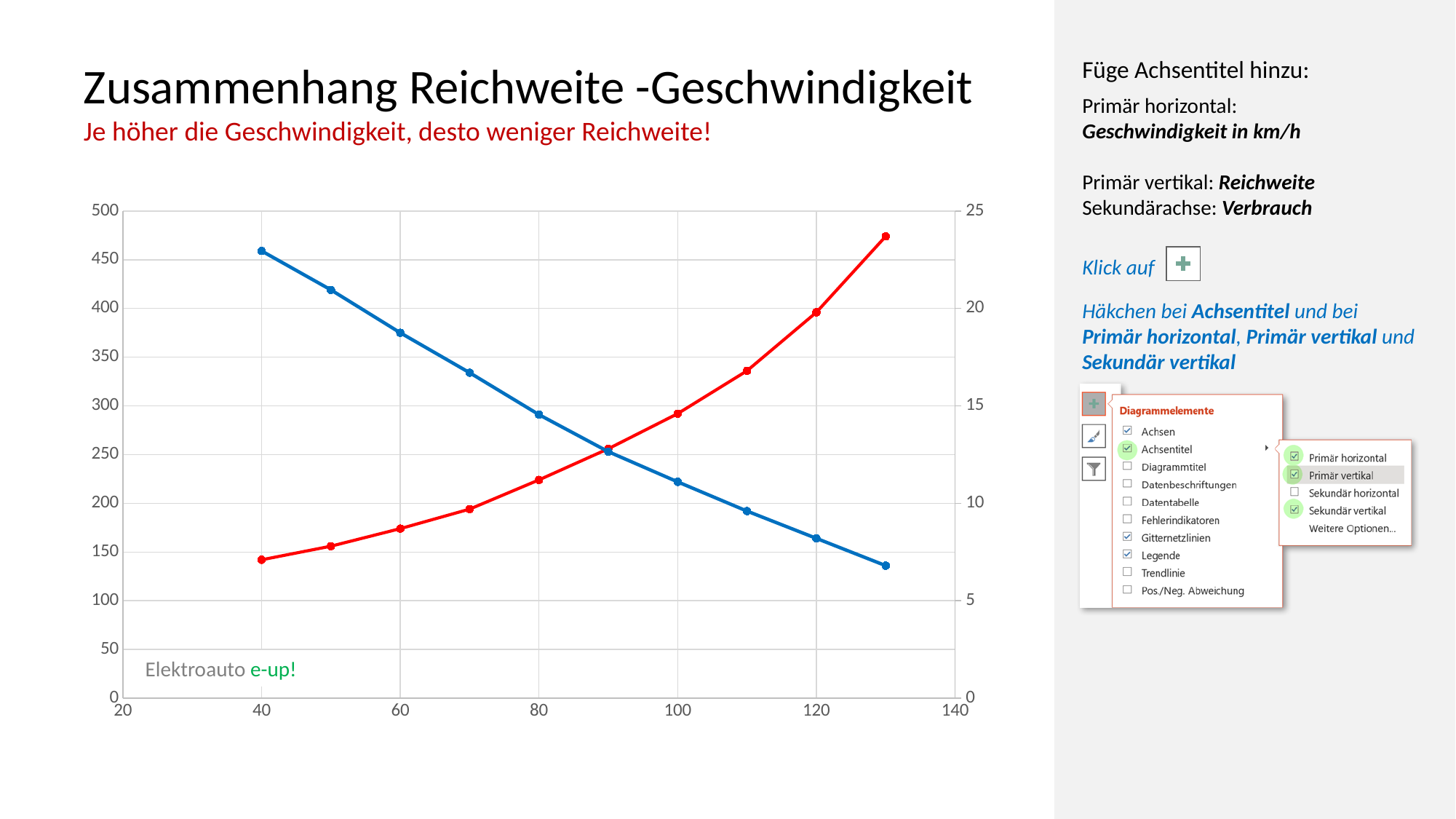
How many data points does the blue line have? 10 What kind of chart is shown on the slide? line chart At which x-axis value does the blue line reach its highest point? 40 Is the value of the blue line at x = 40 greater or less than 450 on the left axis? greater What is the highest tick value shown on the right-hand (secondary) vertical axis? 25 At which x-axis value does the red line reach its highest point? 130 Is the value of the blue line at x = 130 greater or less than 150 on the left axis? less At which x-axis value does the blue line reach its lowest point? 130 Does the blue line rise or fall as the x-axis value increases from 40 to 130? fall Is the value of the red line at x = 130 greater or less than 20 on the right axis? greater Does the red line rise or fall as the x-axis value increases from 40 to 130? rise